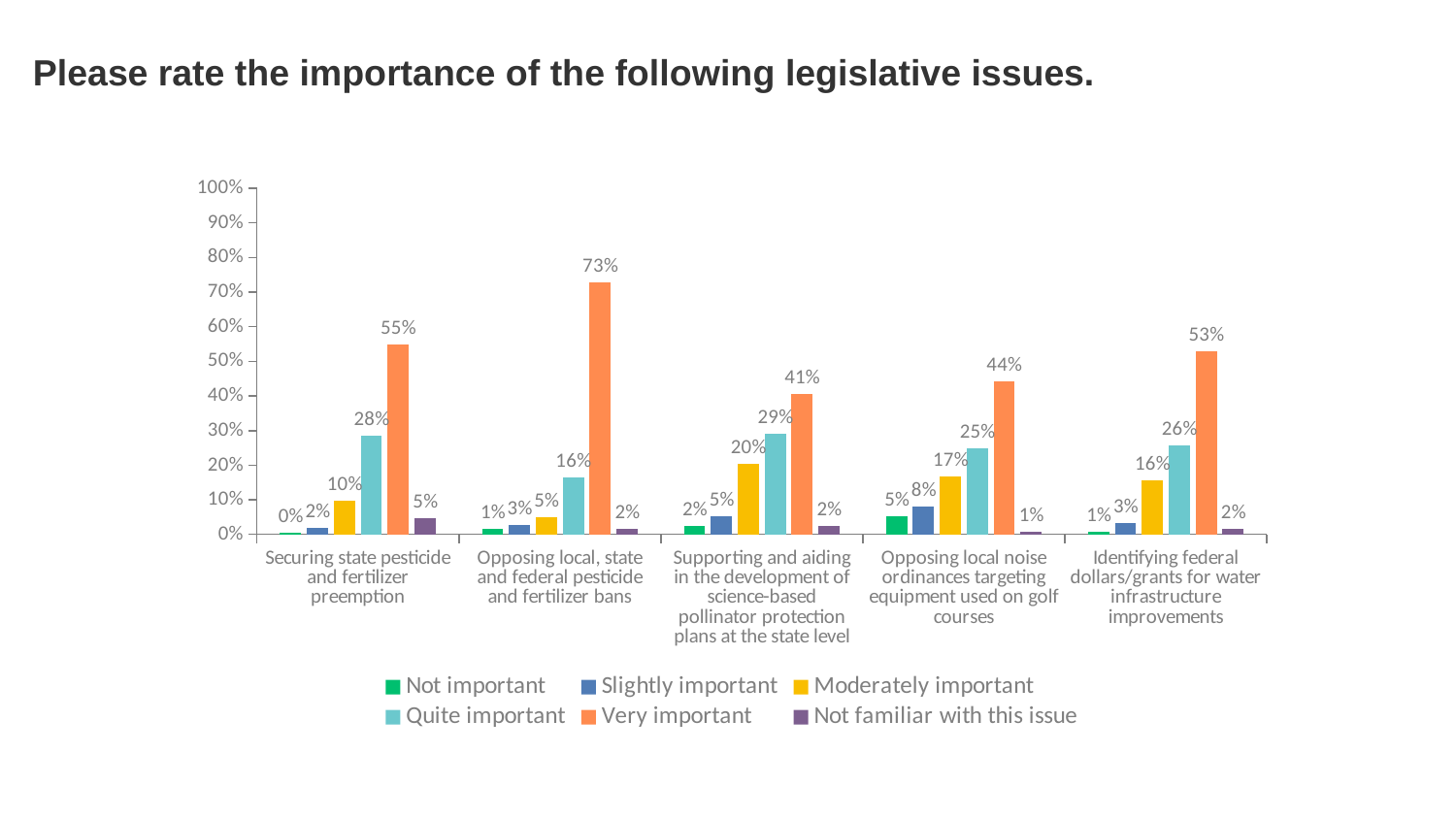
Which colour represents the 'Very important' series in the legend? Orange What kind of chart is shown on the slide? Bar chart What percentage were Not familiar with the issue 'Opposing local noise ordinances targeting equipment used on golf courses'? 1% What percentage rated 'Securing state pesticide and fertilizer preemption' as Quite important? 28% Is the Very important value for 'Identifying federal dollars/grants for water infrastructure improvements' greater or less than 50%? greater Which legislative issue has the highest Very important percentage? Opposing local, state and federal pesticide and fertilizer bans What is the difference between the Very important percentages for 'Opposing local, state and federal pesticide and fertilizer bans' and 'Securing state pesticide and fertilizer preemption'? 18% What percentage rated 'Opposing local, state and federal pesticide and fertilizer bans' as Very important? 73% How many series does the legend list? 6 How many legislative issues are shown on the x axis? 5 Which is larger: the Moderately important percentage for the pollinator protection plans issue or for the noise ordinances issue? Pollinator protection plans (20%) Which legislative issue has the lowest Very important percentage? Supporting and aiding in the development of science-based pollinator protection plans at the state level